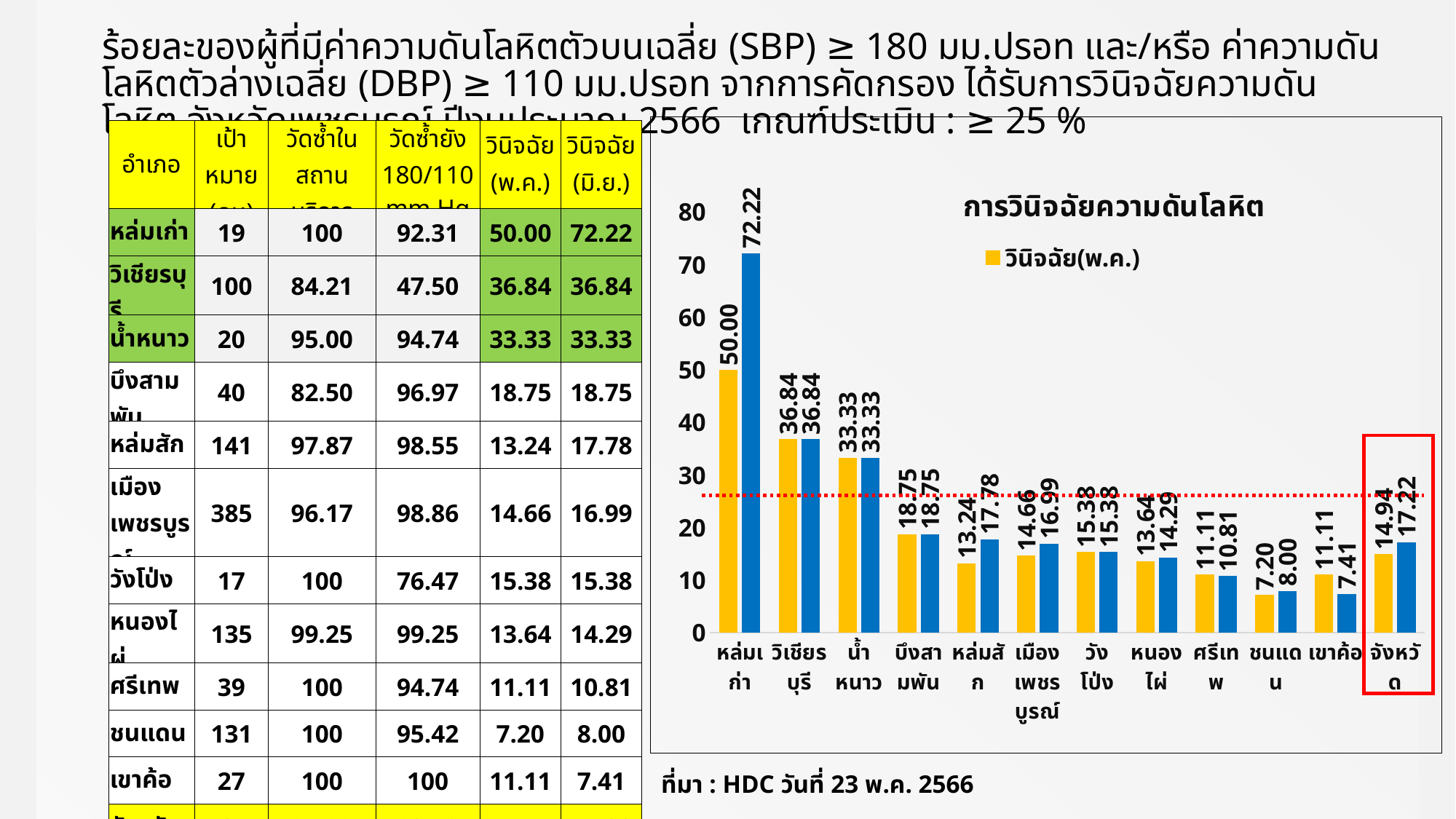
What type of chart is shown on the slide? bar chart What is the value of the blue bar for ชนแดน? 8.00 What is the value of the blue bar for หล่มเก่า? 72.22 What is the value of the วินิจฉัย(พ.ค.) (yellow) bar for หล่มเก่า? 50.00 How many categories are shown on the x axis of the chart? 12 Which category has the highest blue bar? หล่มเก่า Which is larger for เขาค้อ, the yellow bar or the blue bar? the yellow bar What is the value of the วินิจฉัย(พ.ค.) (yellow) bar for จังหวัด? 14.94 What is the difference between the blue bar and the yellow bar for หล่มเก่า? 22.22 Is the value of the blue bar for วิเชียรบุรี greater or less than 30? greater What is the title of the chart on the slide? การวินิจฉัยความดันโลหิต Which category has the lowest วินิจฉัย(พ.ค.) (yellow) bar? ชนแดน